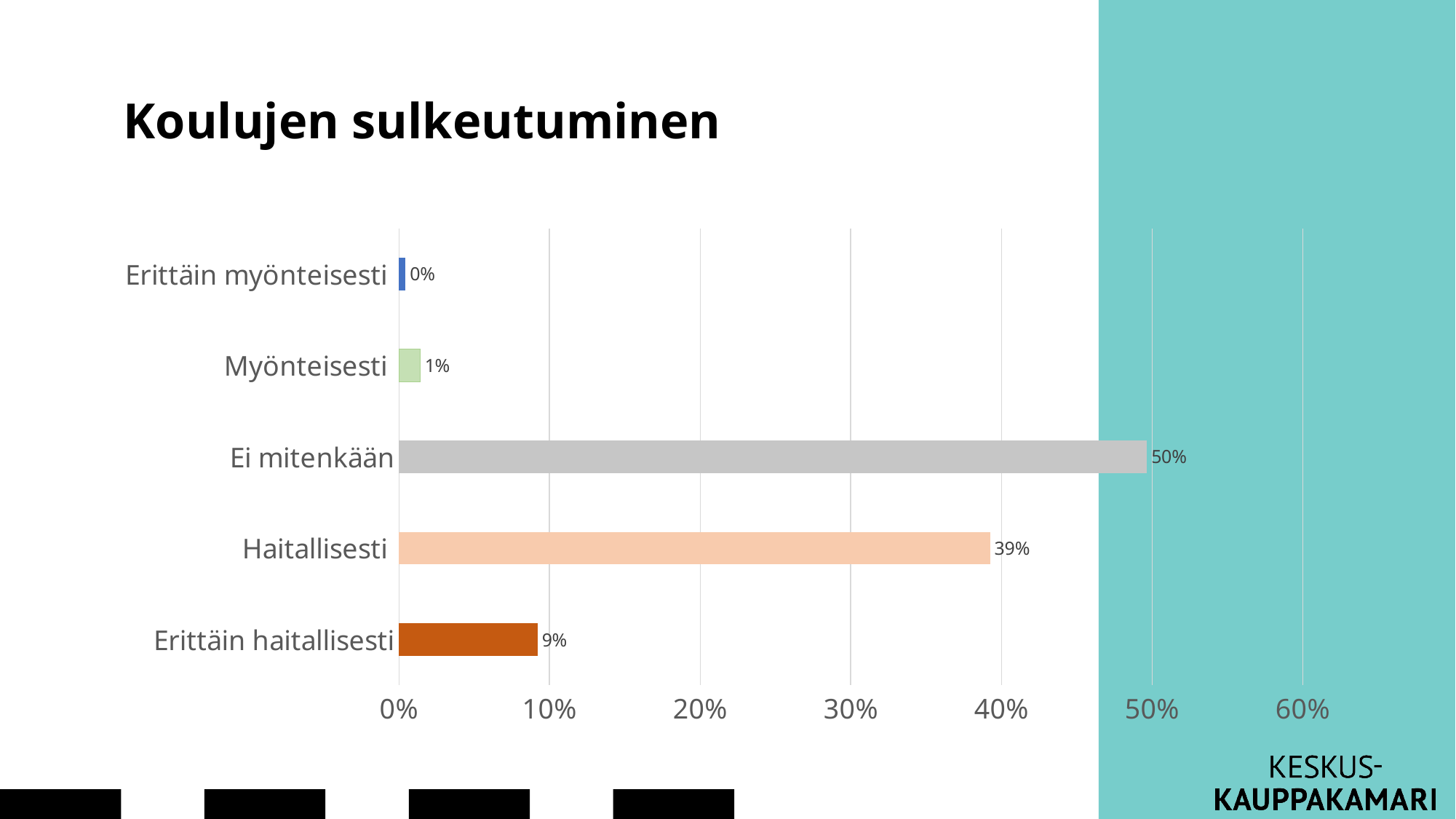
What is the value for Ei mitenkään? 50% What kind of chart is shown on the slide? Bar chart What is the value for Erittäin haitallisesti? 9% What is the value for Myönteisesti? 1% How many categories are shown in the chart? 5 Which category has the highest value? Ei mitenkään Which category has the lowest value? Erittäin myönteisesti What is the value for Haitallisesti? 39% What is the value for Erittäin myönteisesti? 0% What is the title of the chart? Koulujen sulkeutuminen What is the difference between the values for Ei mitenkään and Haitallisesti? 11% Which is larger, the value for Haitallisesti or the value for Erittäin haitallisesti? Haitallisesti